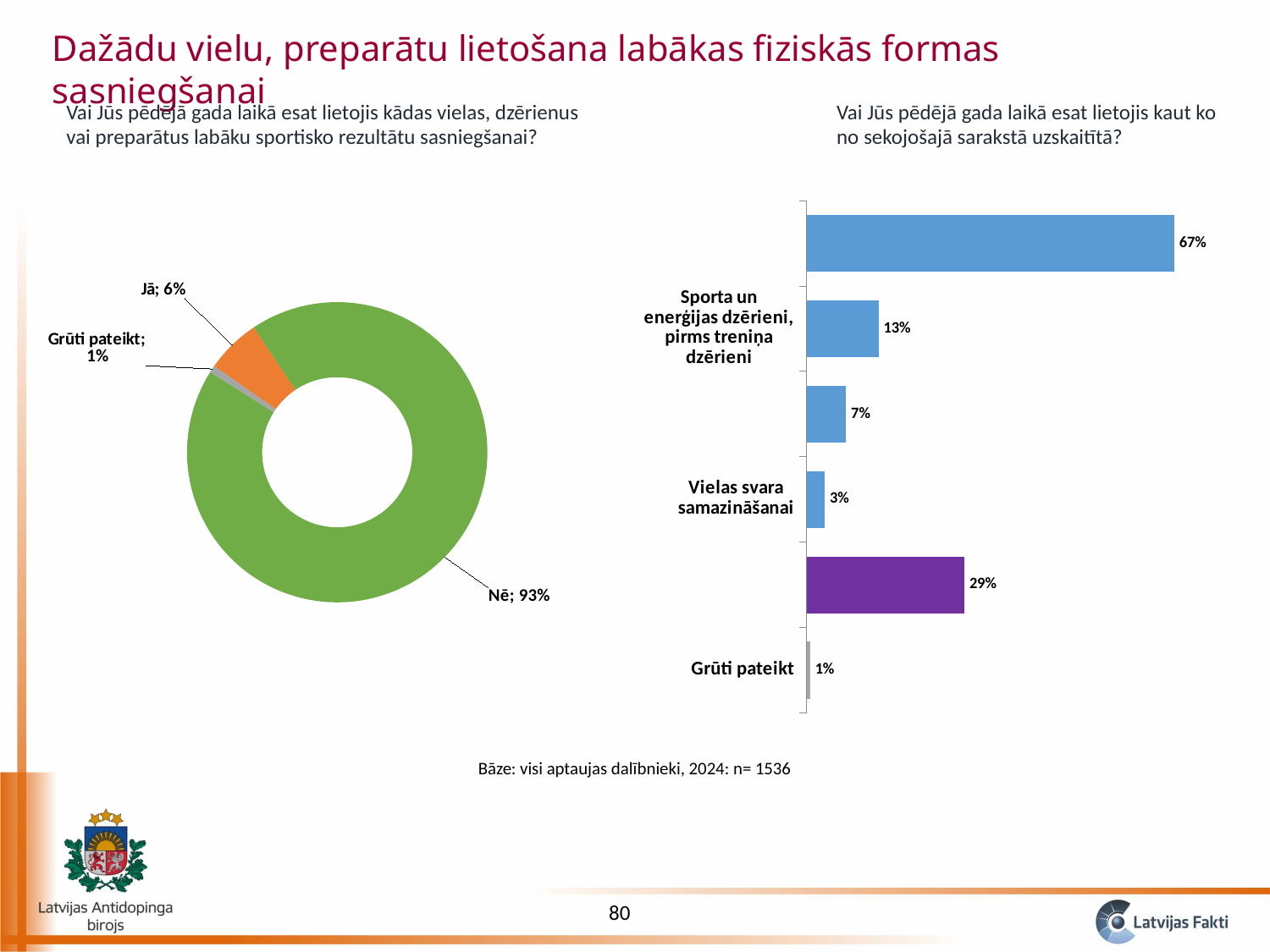
In the left donut chart, which answer has the largest share? Nē In the left donut chart, which answer has the smallest share? Grūti pateikt In the right bar chart, what is the value for "Grūti pateikt"? 1% In the left donut chart, what share of respondents answered "Jā"? 6% In the left donut chart, what share of respondents answered "Grūti pateikt"? 1% In the right bar chart, what is the value for "Vielas svara samazināšanai"? 3% What type of chart is shown on the left side of the slide? Donut (pie) chart In the left donut chart, what share of respondents answered "Nē"? 93% In the right bar chart, how many bars are plotted? 6 In the right bar chart, what is the value for "Sporta un enerģijas dzērieni, pirms treniņa dzērieni"? 13% In the right bar chart, what is the difference between "Sporta un enerģijas dzērieni, pirms treniņa dzērieni" and "Vielas svara samazināšanai"? 10% In the left donut chart, how many slices are there? 3